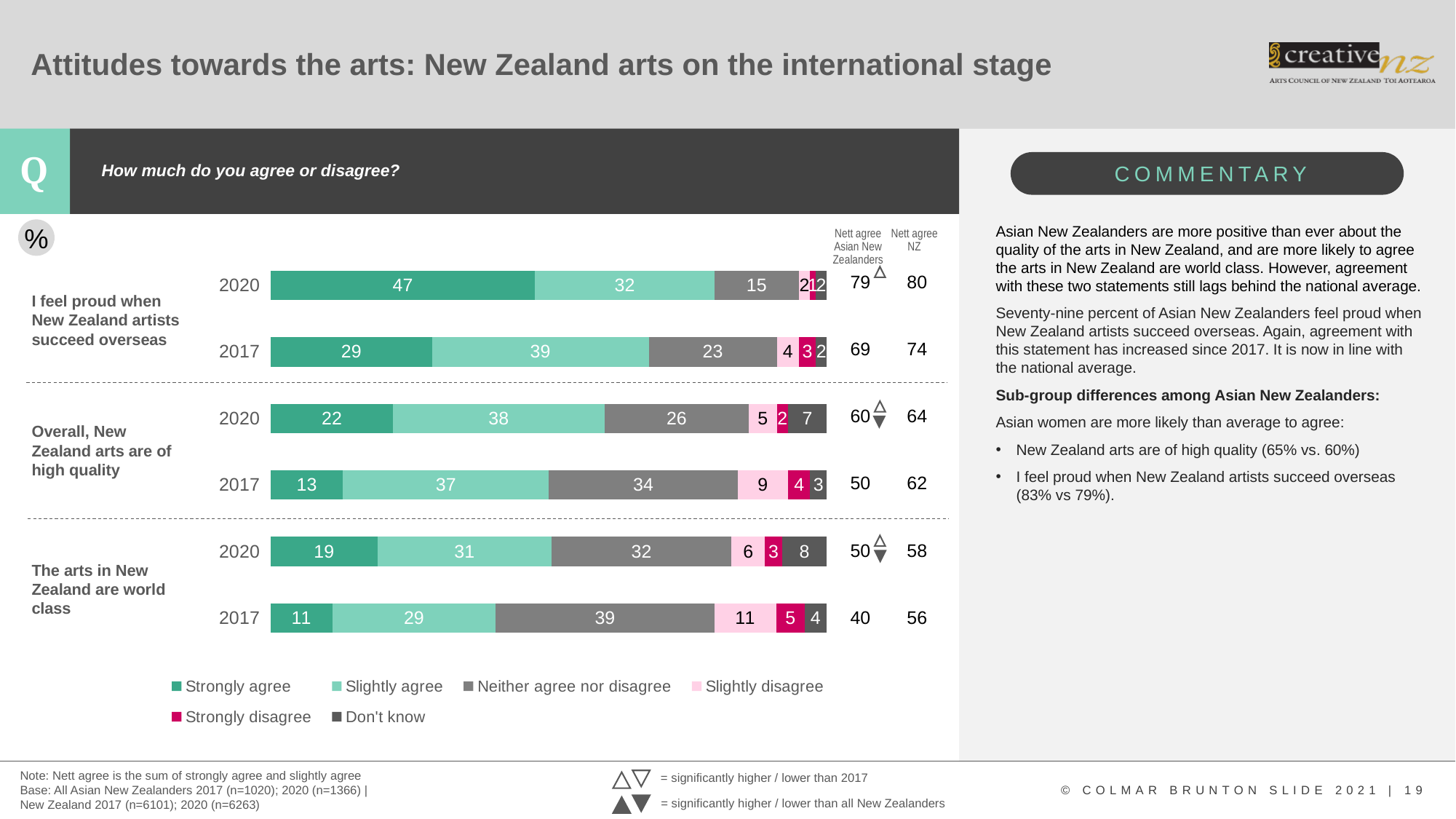
What is the 'Slightly agree' value for 'Overall, New Zealand arts are of high quality' in 2020? 38 In 2020, which statement had the larger 'Strongly agree' value: 'Overall, New Zealand arts are of high quality' or 'The arts in New Zealand are world class'? Overall, New Zealand arts are of high quality How many series does the chart legend list? 6 What is the 'Neither agree nor disagree' value for 'The arts in New Zealand are world class' in 2017? 39 What is the Nett agree figure for Asian New Zealanders for 'The arts in New Zealand are world class' in 2020? 50 Which bar has the largest 'Strongly agree' segment? I feel proud when New Zealand artists succeed overseas, 2020 Which bar has the smallest 'Strongly agree' segment? The arts in New Zealand are world class, 2017 What percentage of Asian New Zealanders strongly agreed in 2020 that they feel proud when New Zealand artists succeed overseas? 47 What kind of chart is shown on the slide? Stacked bar chart What is the 'Don't know' value for 'The arts in New Zealand are world class' in 2020? 8 By how many points did 'Strongly agree' for 'I feel proud when New Zealand artists succeed overseas' increase from 2017 to 2020? 18 How many bars are plotted in the chart? 6